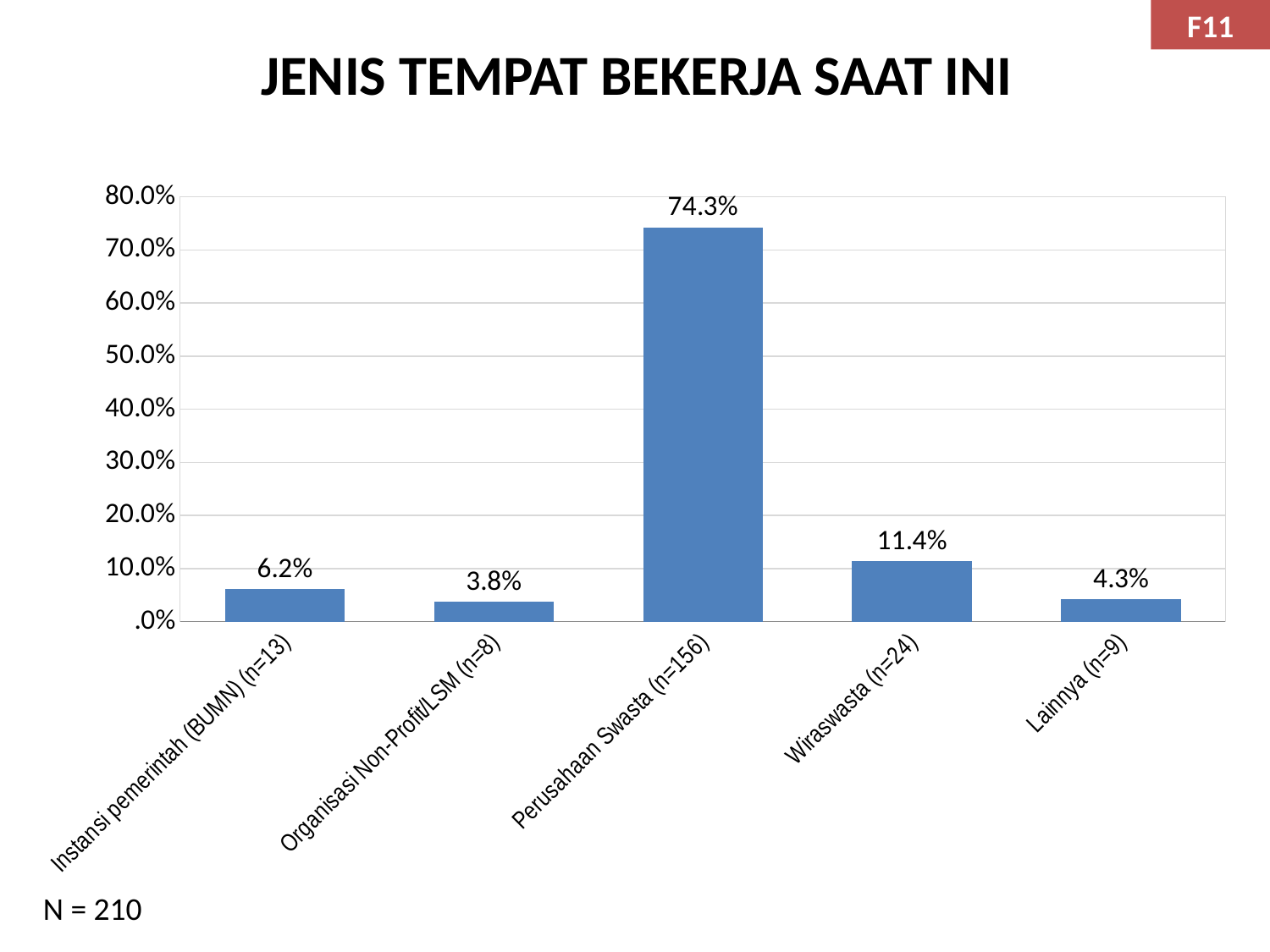
What is the value for Lainnya (n=9)? 4.3% What is the value for Wiraswasta (n=24)? 11.4% What is the title of the chart? JENIS TEMPAT BEKERJA SAAT INI What is the difference between the values for Perusahaan Swasta (n=156) and Wiraswasta (n=24)? 62.9% Which category has the lowest value? Organisasi Non-Profit/LSM (n=8) What kind of chart is shown on the slide? Bar chart What is the value for Perusahaan Swasta (n=156)? 74.3% What is the value for Instansi pemerintah (BUMN) (n=13)? 6.2% Which is larger, the value for Instansi pemerintah (BUMN) (n=13) or the value for Lainnya (n=9)? Instansi pemerintah (BUMN) (n=13) Which category has the highest value? Perusahaan Swasta (n=156) How many categories are shown on the x axis? 5 What is the value for Organisasi Non-Profit/LSM (n=8)? 3.8%